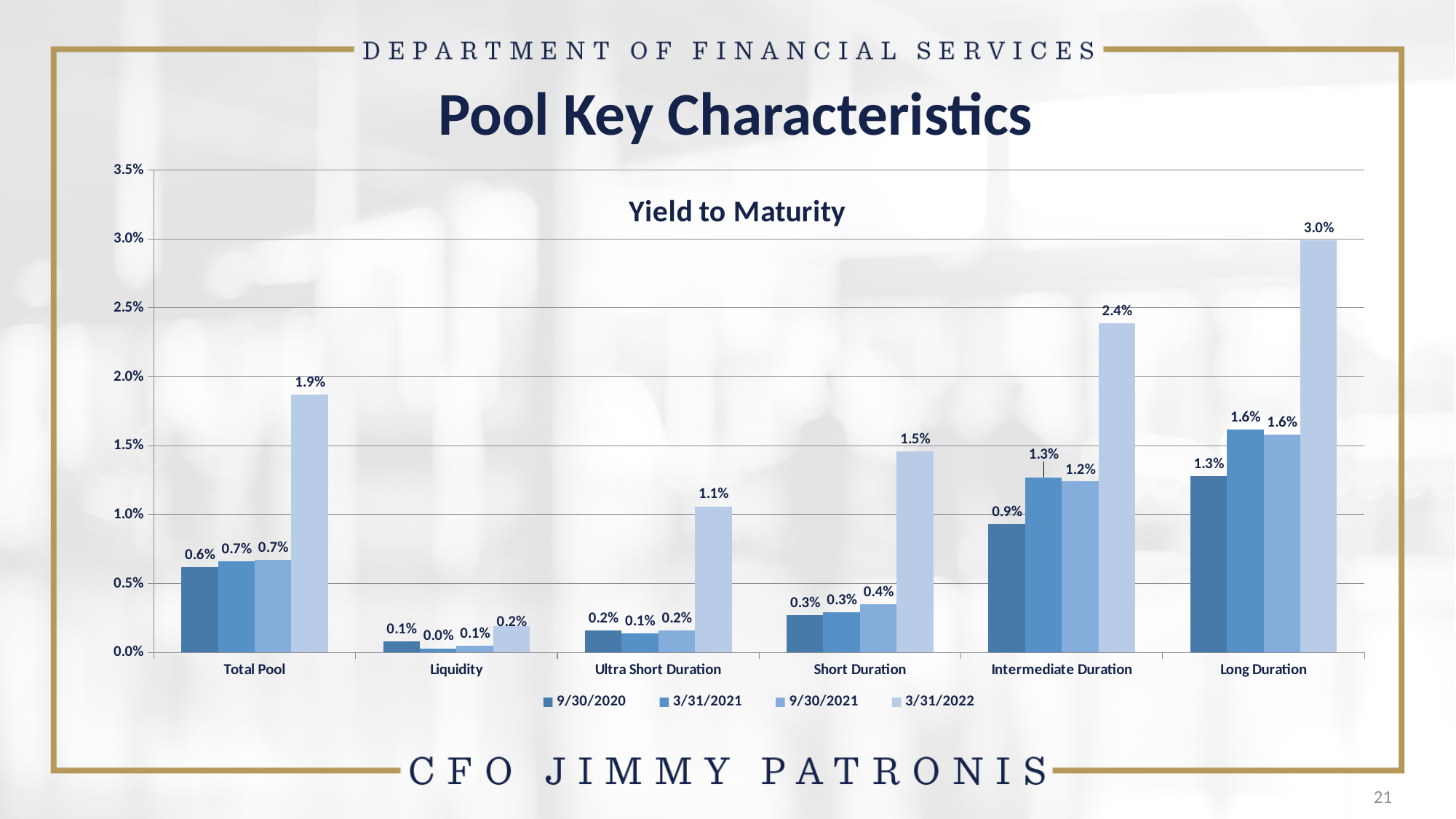
Which category has the lowest Yield to Maturity for the 3/31/2022 series? Liquidity What is the Yield to Maturity for Short Duration on 9/30/2021? 0.4% What kind of chart is used to show Yield to Maturity? Bar chart How many series does the legend of the Yield to Maturity chart list? 4 What is the difference between the 3/31/2022 and 9/30/2021 Yield to Maturity for Intermediate Duration? 1.2% What is the title of the chart on the slide? Yield to Maturity What is the Yield to Maturity for Total Pool on 9/30/2020? 0.6% What is the Yield to Maturity for Intermediate Duration on 3/31/2021? 1.3% How many categories are shown on the x axis of the Yield to Maturity chart? 6 What is the Yield to Maturity for Long Duration on 3/31/2022? 3.0% Which category has the highest Yield to Maturity for the 3/31/2022 series? Long Duration Which is larger for Ultra Short Duration: the 3/31/2022 value or the 9/30/2021 value? 3/31/2022